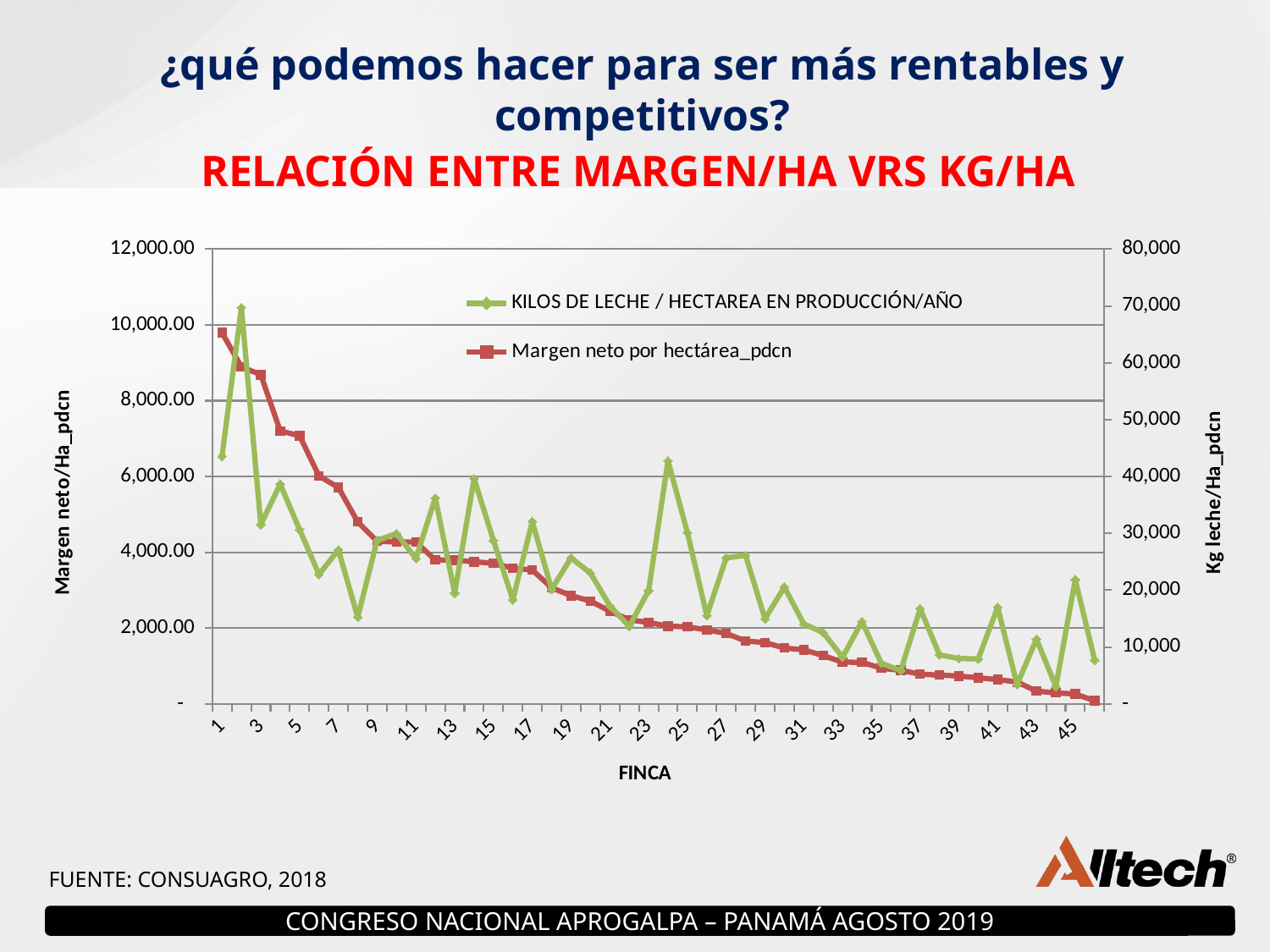
Is the Margen neto por hectárea_pdcn value for finca 45 greater or less than 2,000.00? less Which finca has the highest value for KILOS DE LECHE / HECTAREA EN PRODUCCIÓN/AÑO? 2 What kind of chart is shown on the slide? line chart What are the two series named in the chart legend? KILOS DE LECHE / HECTAREA EN PRODUCCIÓN/AÑO and Margen neto por hectárea_pdcn Which finca has the highest value for Margen neto por hectárea_pdcn? 1 Which finca has the larger Margen neto por hectárea_pdcn value, finca 1 or finca 45? finca 1 Is the KILOS DE LECHE / HECTAREA EN PRODUCCIÓN/AÑO value for finca 2 greater or less than 60,000? greater How many series does the chart legend list? 2 Is the Margen neto por hectárea_pdcn value for finca 1 greater or less than 8,000.00? greater Does the Margen neto por hectárea_pdcn series rise or fall as the finca number increases along the x axis? fall What is the title of the x axis of the chart? FINCA